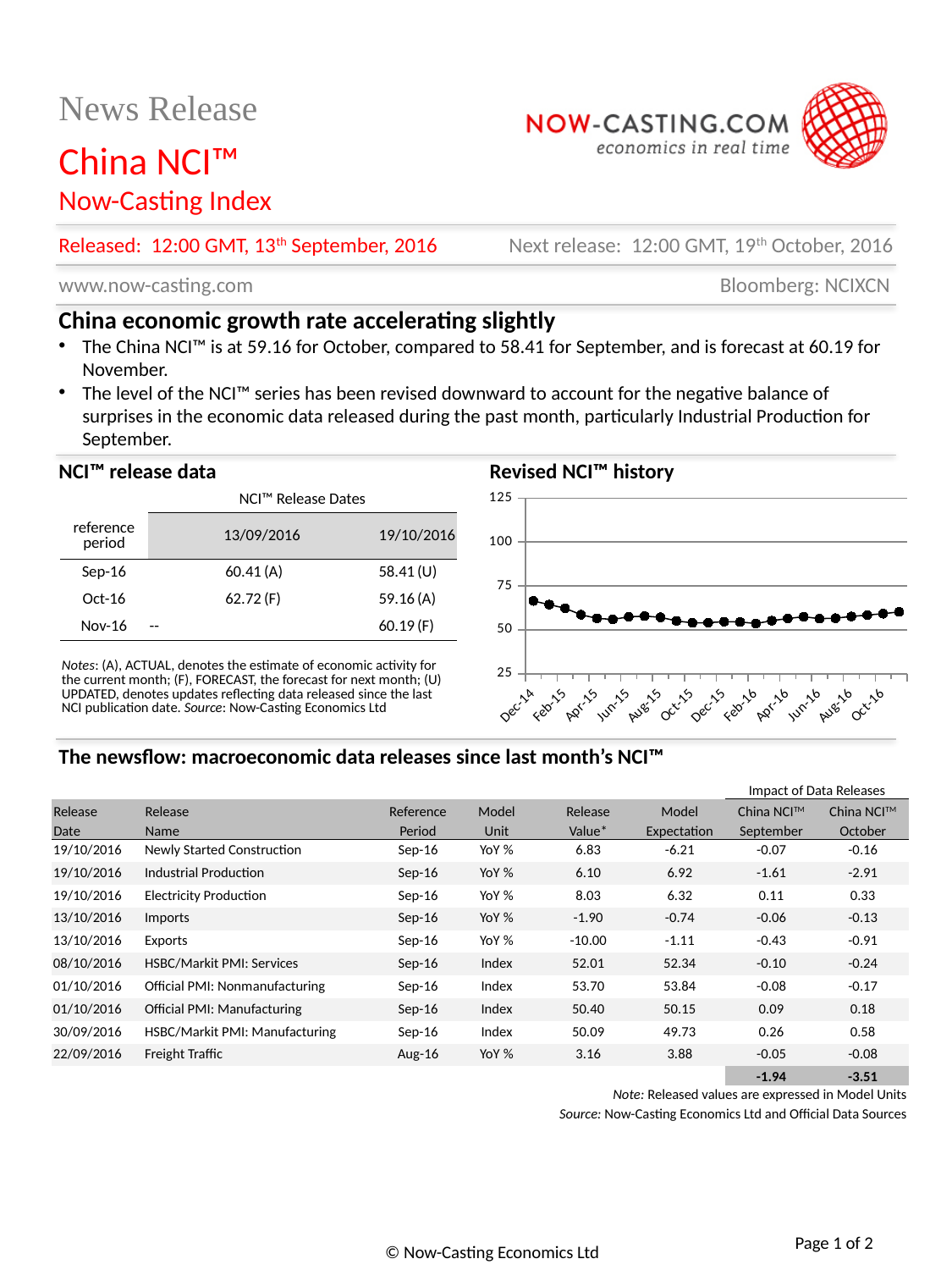
In the "Revised NCI™ history" chart, do the values rise or fall from Dec-14 to Oct-15? fall In the "Revised NCI™ history" chart, is the value for Dec-14 greater or less than 50? greater In the "Revised NCI™ history" chart, is the value for Oct-16 greater or less than 50? greater In the "Revised NCI™ history" chart, do the values rise or fall from Feb-16 to Oct-16? rise How many month labels are shown on the x axis of the "Revised NCI™ history" chart? 12 In the "Revised NCI™ history" chart, which is larger, the value for Dec-14 or the value for Oct-16? Dec-14 In the "Revised NCI™ history" chart, which month has the highest value? Dec-14 In the "Revised NCI™ history" chart, is the value for Oct-16 greater or less than 75? less What is the title of the chart on the slide? Revised NCI™ history What is the highest tick value on the y axis of the "Revised NCI™ history" chart? 125 What kind of chart is the "Revised NCI™ history" chart? line chart